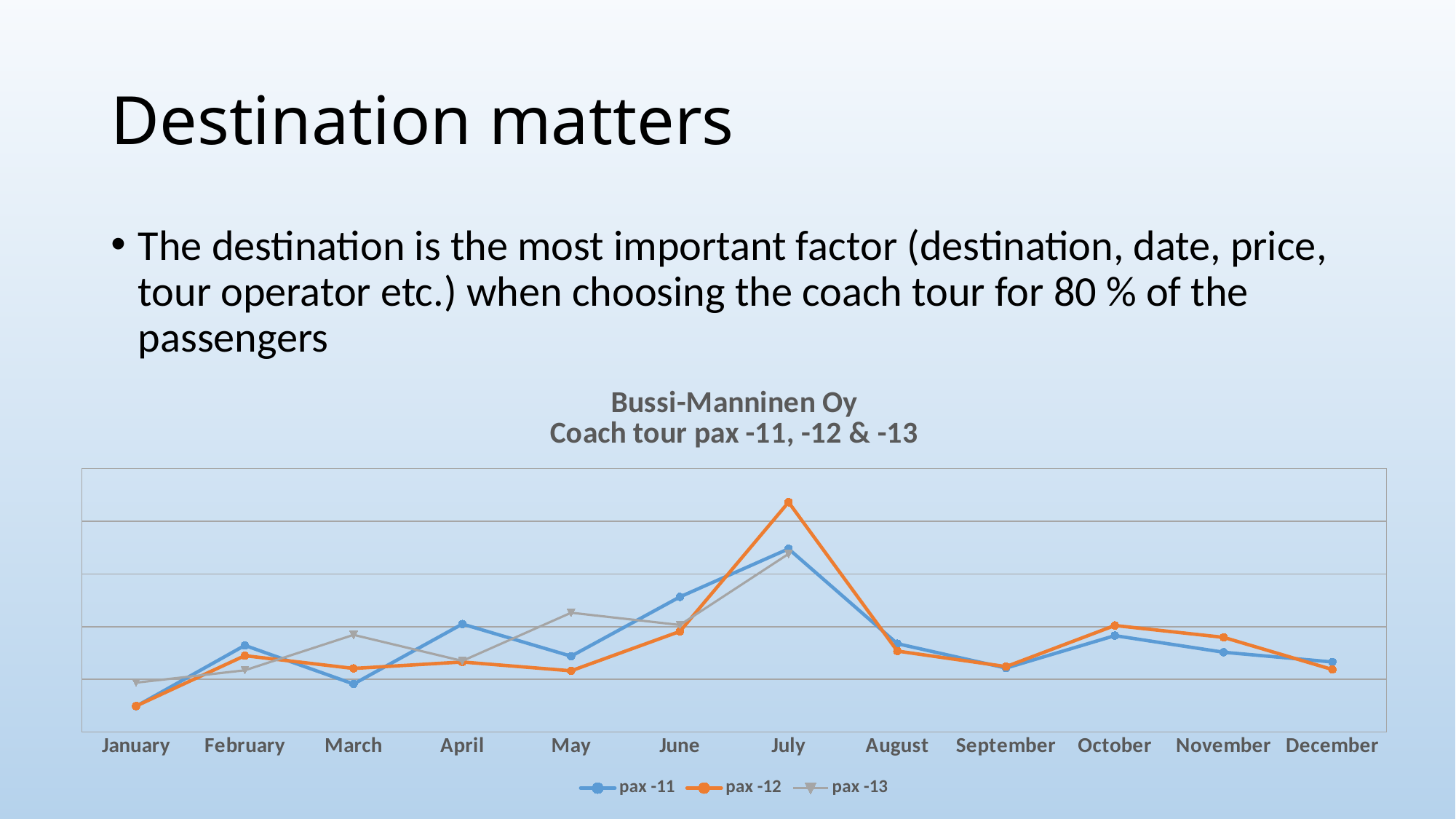
What kind of chart is shown on the slide? line chart Does the pax -12 series rise or fall from July to August? fall In June, which series has the higher value, pax -11 or pax -12? pax -11 How many series does the legend list? 3 In which month is the pax -11 series at its lowest? January What is the title of the chart? Bussi-Manninen Oy Coach tour pax -11, -12 & -13 In which month does the pax -11 series reach its highest value? July Which series is drawn in orange? pax -12 In which month is the pax -12 series at its lowest? January In which month does the pax -12 series reach its highest value? July In July, which series has the higher value, pax -11 or pax -12? pax -12 How many months are shown on the x axis? 12